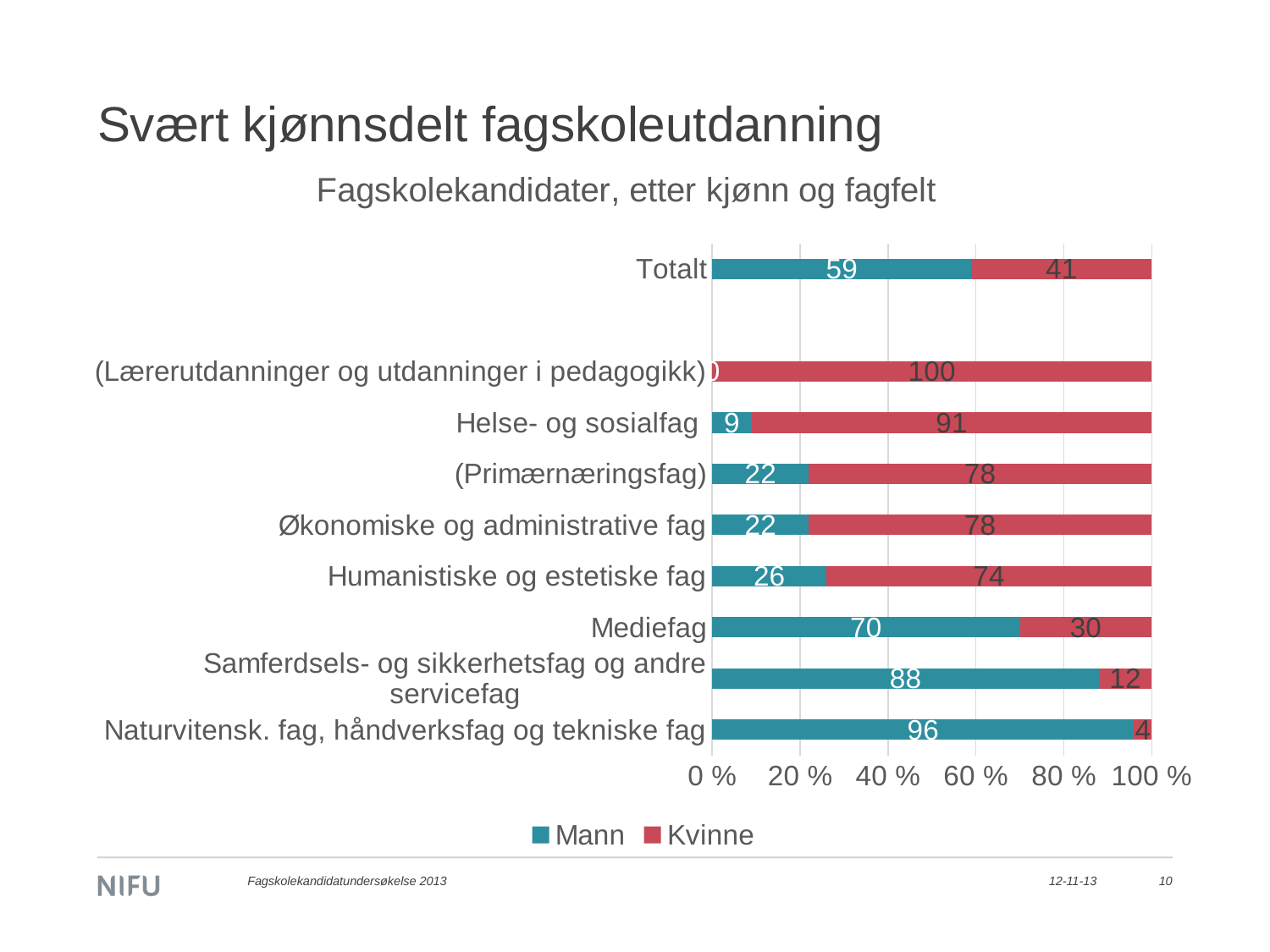
What is the Kvinne value for Helse- og sosialfag? 91 What kind of chart is shown on the slide? Stacked bar chart Which category has the lowest Kvinne value? Naturvitensk. fag, håndverksfag og tekniske fag What is the difference between the Mann and Kvinne values for Mediefag? 40 What is the total of the stacked bar for Økonomiske og administrative fag? 100 How many series does the legend list? 2 What is the title of the chart? Fagskolekandidater, etter kjønn og fagfelt What is the Mann value for Totalt? 59 Which category has the highest Mann value? Naturvitensk. fag, håndverksfag og tekniske fag Which is larger, the Mann value for Humanistiske og estetiske fag or the Mann value for Samferdsels- og sikkerhetsfag og andre servicefag? Samferdsels- og sikkerhetsfag og andre servicefag How many categories are plotted on the chart? 9 What is the Mann value for Mediefag? 70